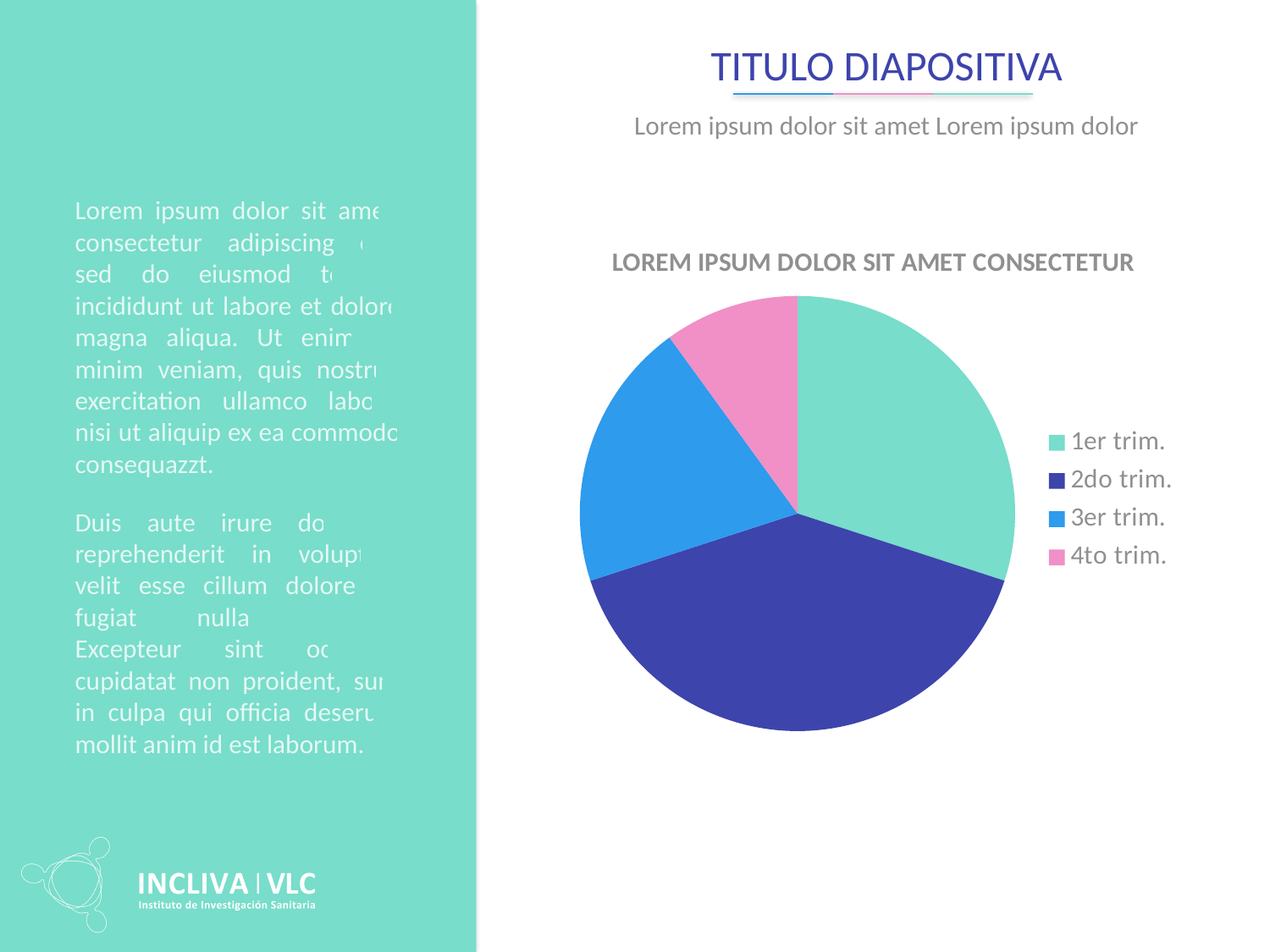
Which category has the largest slice in the pie chart? 2do trim. How many slices does the pie chart have? 4 Which slice is larger in the pie chart, 3er trim. or 4to trim.? 3er trim. Which slice is larger in the pie chart, 2do trim. or 4to trim.? 2do trim. How many entries does the legend of the pie chart list? 4 Which category is shown in pink in the pie chart? 4to trim. Which slice is larger in the pie chart, 1er trim. or 3er trim.? 1er trim. What kind of chart is shown on the slide? pie chart What is the title of the pie chart? LOREM IPSUM DOLOR SIT AMET CONSECTETUR Which category has the smallest slice in the pie chart? 4to trim.